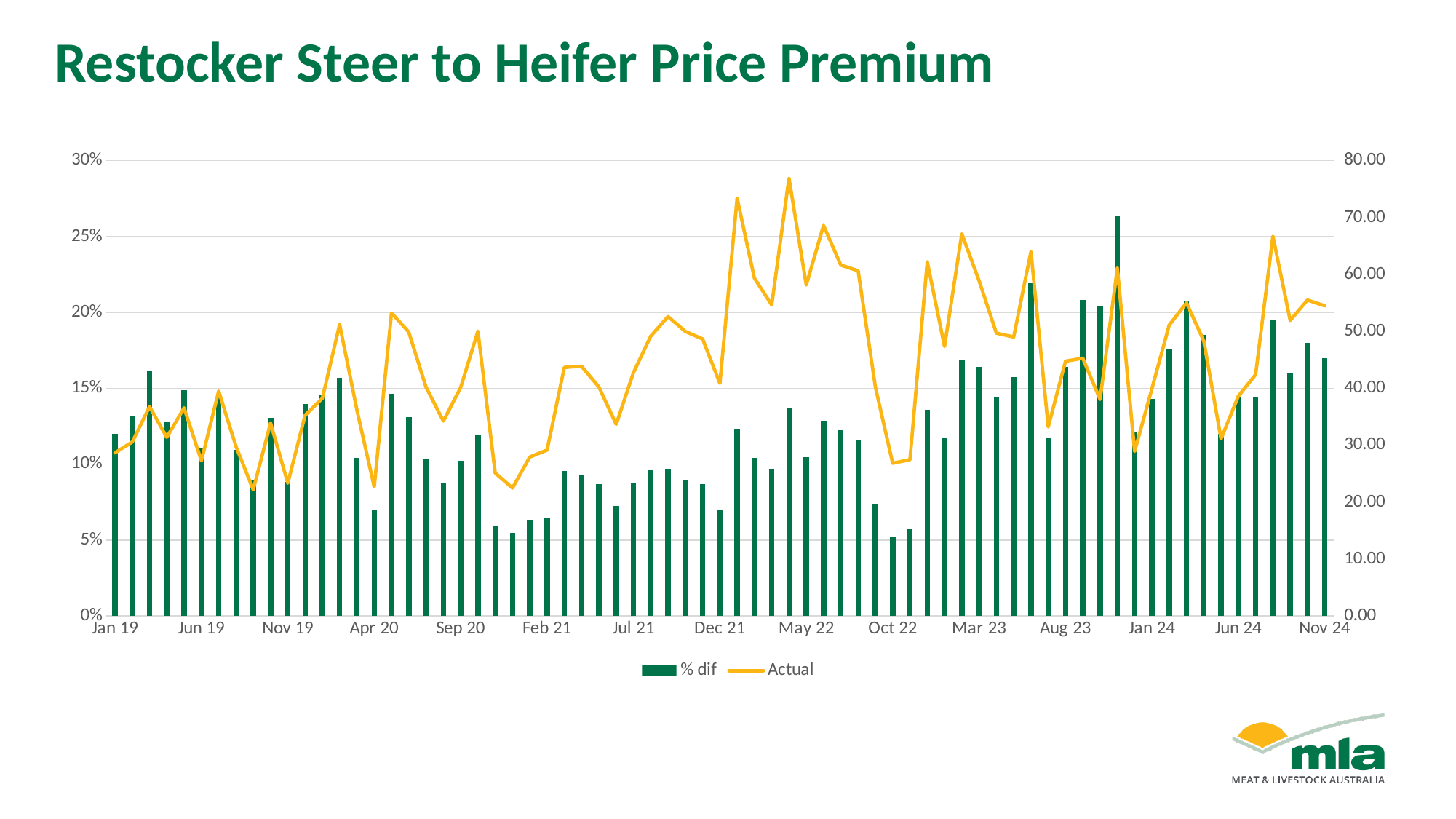
Is the % dif value for Jan 19 greater or less than 10%? greater Is the % dif value for Nov 24 greater or less than 15%? greater What is the title of the chart? Restocker Steer to Heifer Price Premium Is the % dif value for Feb 21 greater or less than 10%? less How many series does the legend list? 2 Which has the larger % dif value, Mar 23 or Feb 21? Mar 23 Does the Actual line generally rise or fall from Jan 19 to Nov 24? rise Which series is drawn as a line rather than bars? Actual